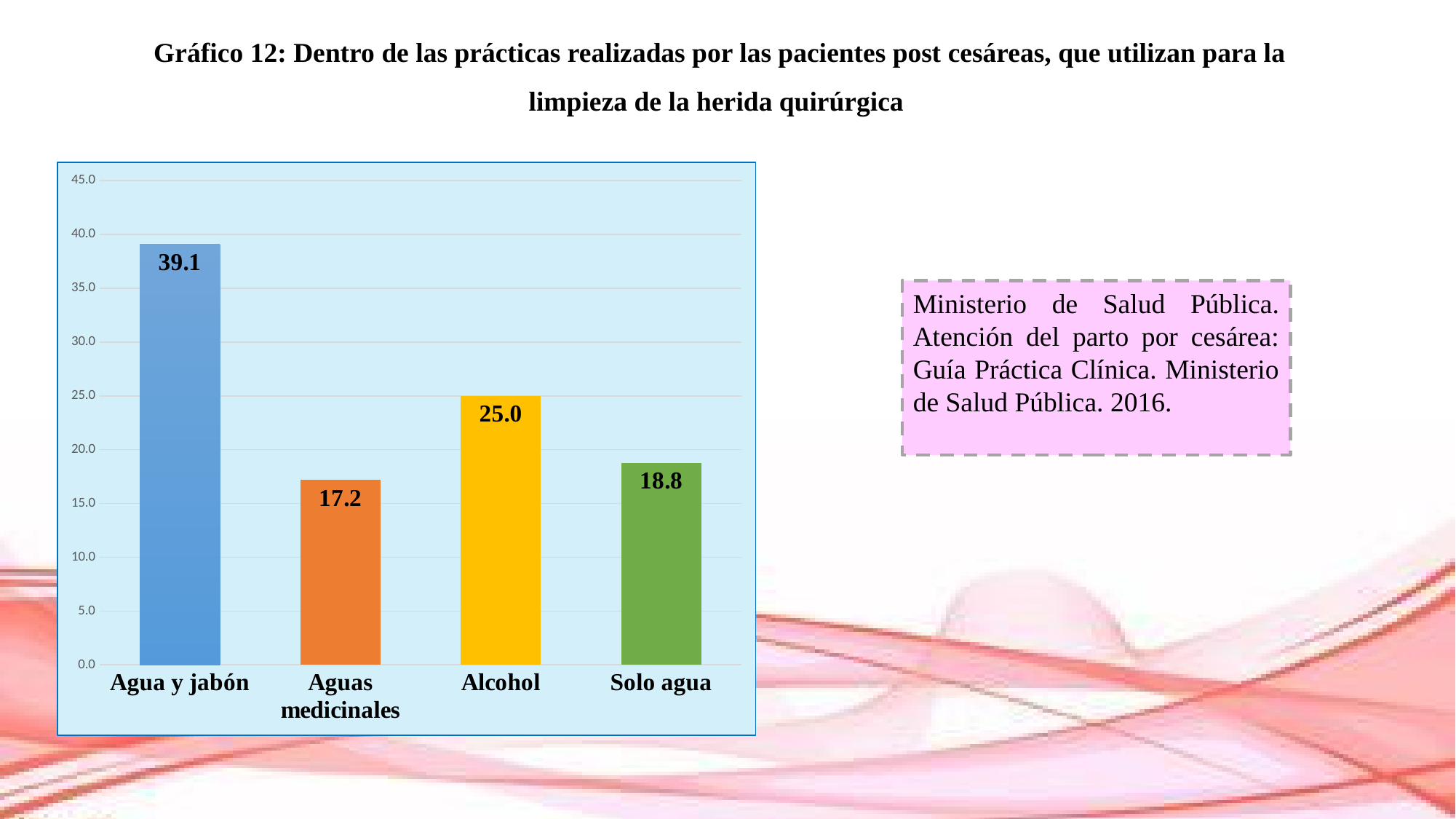
Which is larger, the value for Solo agua or the value for Aguas medicinales? Solo agua What colour is the bar for Alcohol? Yellow How many categories are shown in the chart? 4 What is the value for Aguas medicinales? 17.2 Which category has the highest value? Agua y jabón What is the value for Agua y jabón? 39.1 What is the difference between the values for Agua y jabón and Alcohol? 14.1 Which category has the lowest value? Aguas medicinales What is the value for Solo agua? 18.8 What kind of chart is shown on the slide? Bar chart Is the value for Agua y jabón greater or less than 35.0? greater What is the value for Alcohol? 25.0